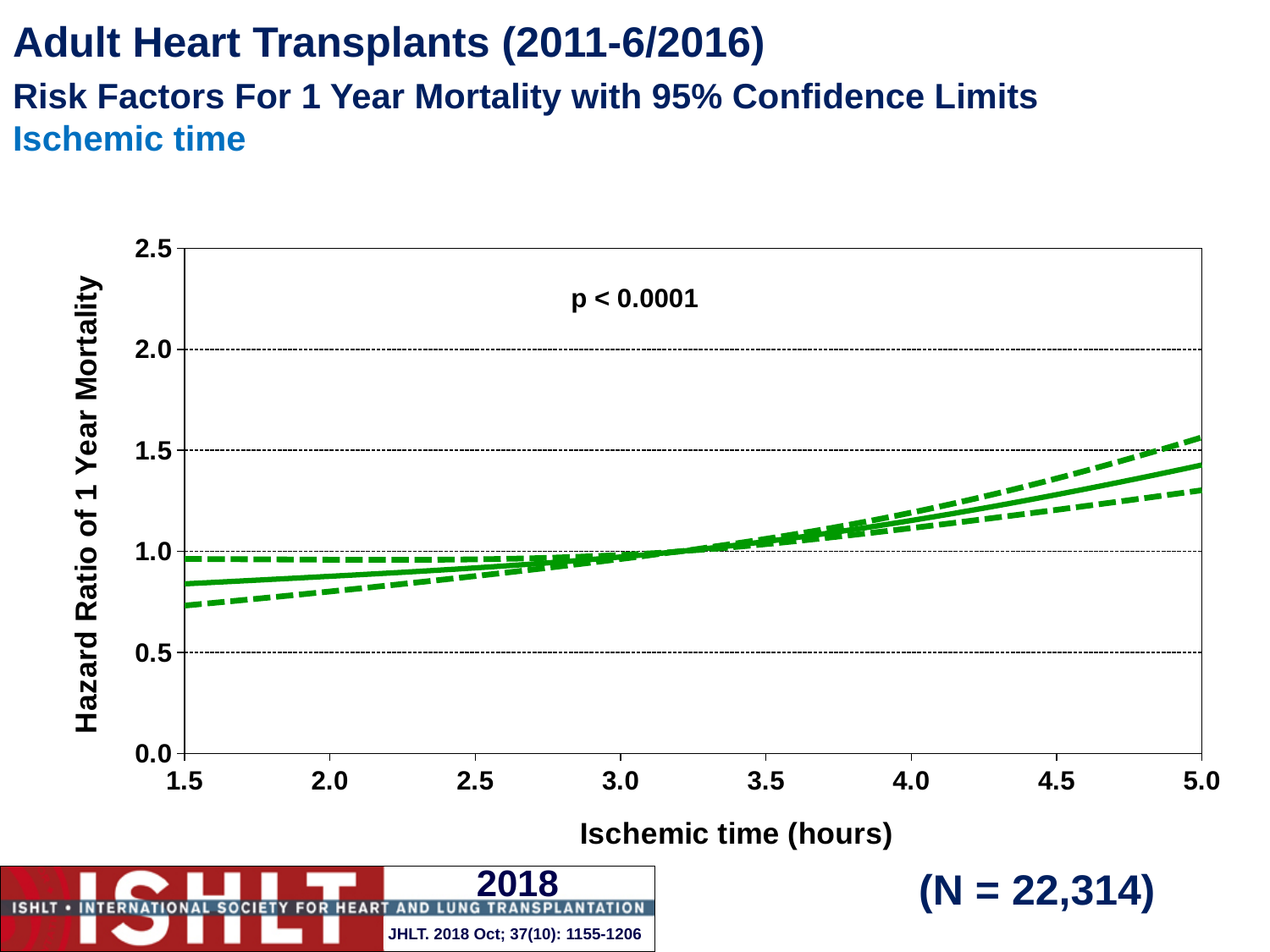
Is the hazard ratio (solid line) at an ischemic time of 1.5 hours greater or less than 1.0? less Does the hazard ratio of 1 year mortality rise or fall as ischemic time increases from 1.5 to 5.0 hours? Rises What is the label of the x axis? Ischemic time (hours) What is the sample size (N) shown on the slide? N = 22,314 Is the hazard ratio (solid line) at an ischemic time of 5.0 hours greater or less than 1.0? greater Is the lower 95% confidence limit at an ischemic time of 1.5 hours greater or less than 0.5? greater What is the highest value shown on the y axis? 2.5 How many lines are plotted on the chart (the estimate plus its confidence limits)? 3 What kind of chart is shown on the slide? Line chart What p-value is printed on the chart? p < 0.0001